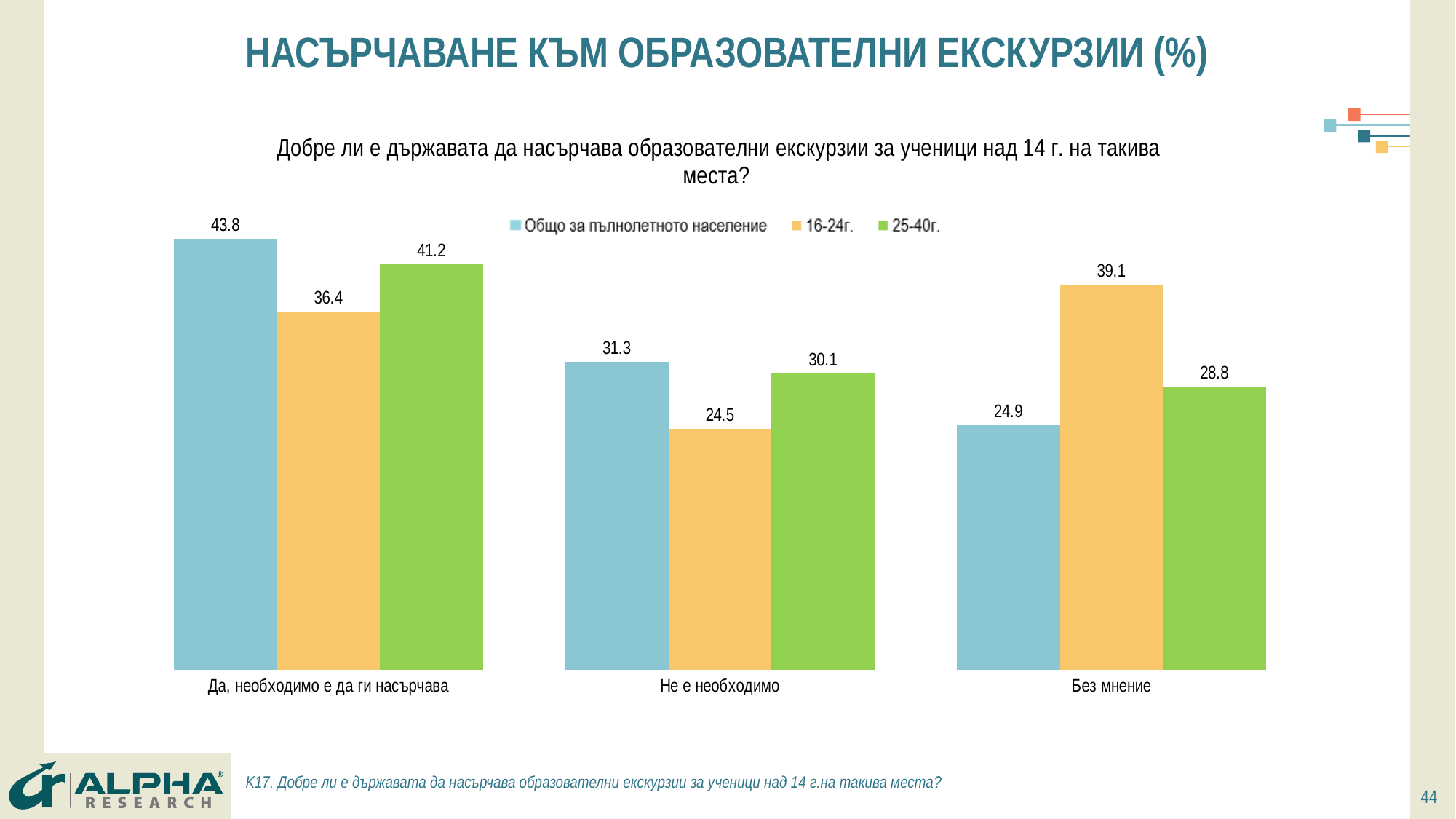
Which category has the lowest value for 'Общо за пълнолетното население'? Без мнение What kind of chart is shown on the slide? Bar chart In the 'Не е необходимо' category, which series has the larger value: 'Общо за пълнолетното население' or '16-24г.'? Общо за пълнолетното население What is the difference between the '25-40г.' and '16-24г.' values in the 'Да, необходимо е да ги насърчава' category? 4.8 What is the value for the '25-40г.' series in the 'Не е необходимо' category? 30.1 How many categories are shown on the x axis? 3 Which colour represents the '25-40г.' series? Green Do the values for 'Общо за пълнолетното население' rise or fall from left to right across the categories? Fall What is the value for the '16-24г.' series in the 'Без мнение' category? 39.1 What is the value for 'Общо за пълнолетното население' in the 'Да, необходимо е да ги насърчава' category? 43.8 Which category has the highest value for the '16-24г.' series? Без мнение How many series does the legend list? 3